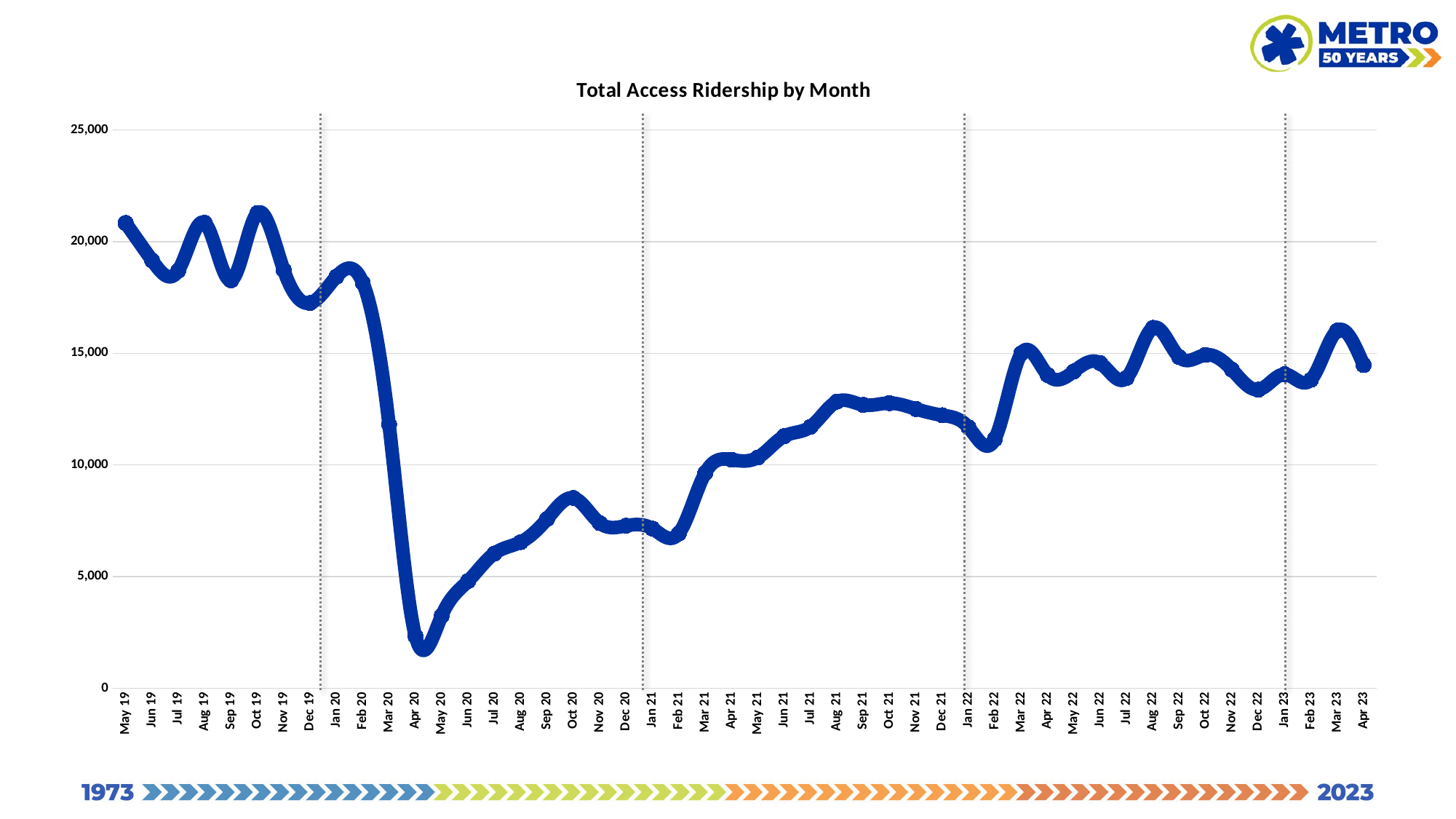
Which month has the lowest ridership? Apr 20 Which month has the highest ridership? Oct 19 What is the title of the chart? Total Access Ridership by Month Do the values rise or fall from Apr 20 to Aug 21? rise What kind of chart is shown on the slide? Line chart How many vertical dotted lines mark year boundaries on the chart? 4 Is the value for Aug 22 greater or less than 15,000? greater Is the value for May 19 greater or less than 20,000? greater How many months are plotted along the x axis? 48 Is the value for Jan 21 greater or less than 10,000? less Which is larger, the value for Oct 19 or the value for Apr 20? Oct 19